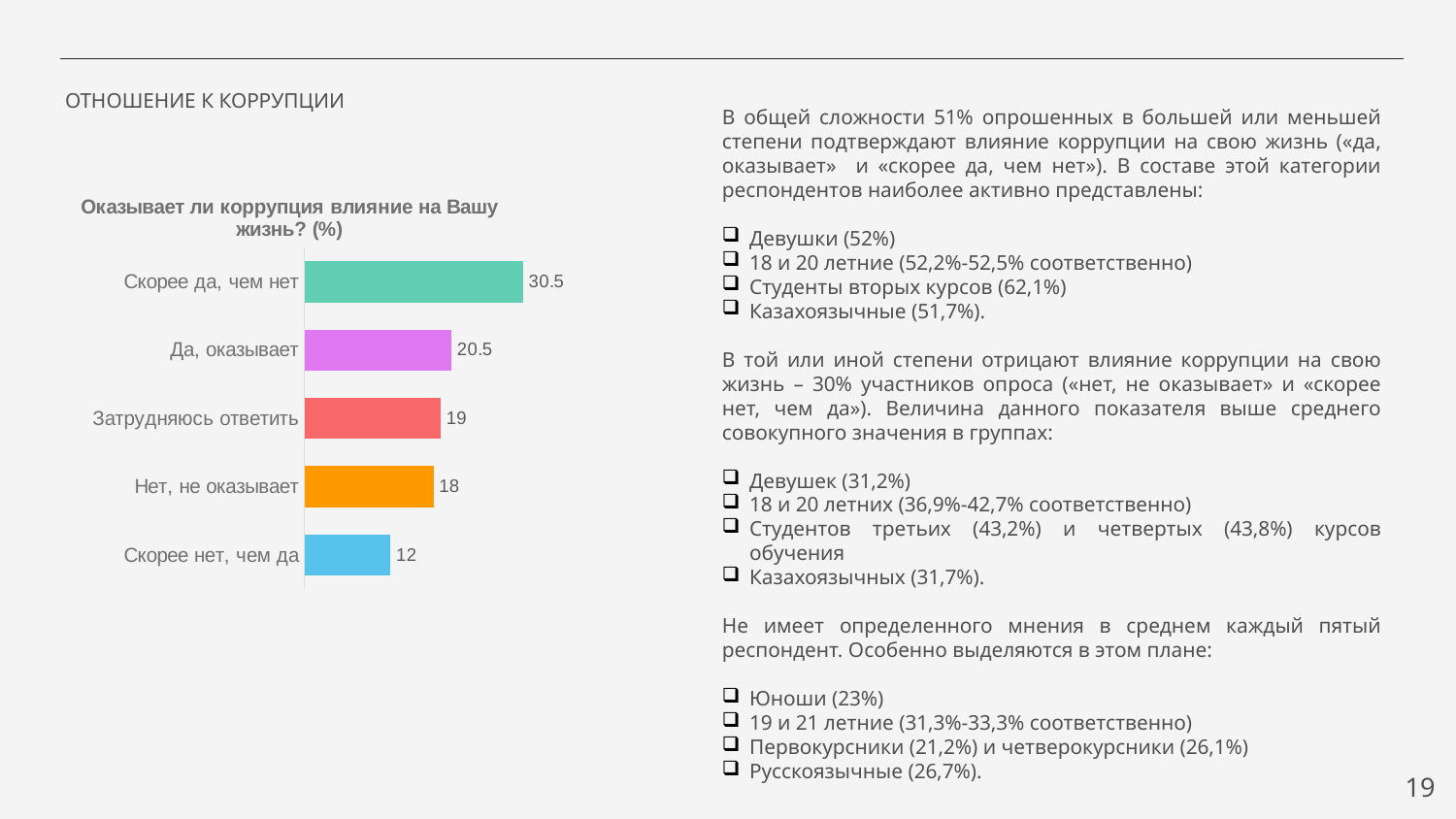
Which category has the lowest value? Скорее нет, чем да What is the value for "Да, оказывает"? 20.5 What kind of chart is shown on the slide? Bar chart What is the value for "Скорее нет, чем да"? 12 What is the title of the chart? Оказывает ли коррупция влияние на Вашу жизнь? (%) How many categories are shown in the chart? 5 Which category has the highest value? Скорее да, чем нет What is the value for "Нет, не оказывает"? 18 What is the value for "Скорее да, чем нет"? 30.5 What is the value for "Затрудняюсь ответить"? 19 Which is larger: the value for "Нет, не оказывает" or the value for "Скорее нет, чем да"? Нет, не оказывает What is the difference between the values for "Скорее да, чем нет" and "Да, оказывает"? 10